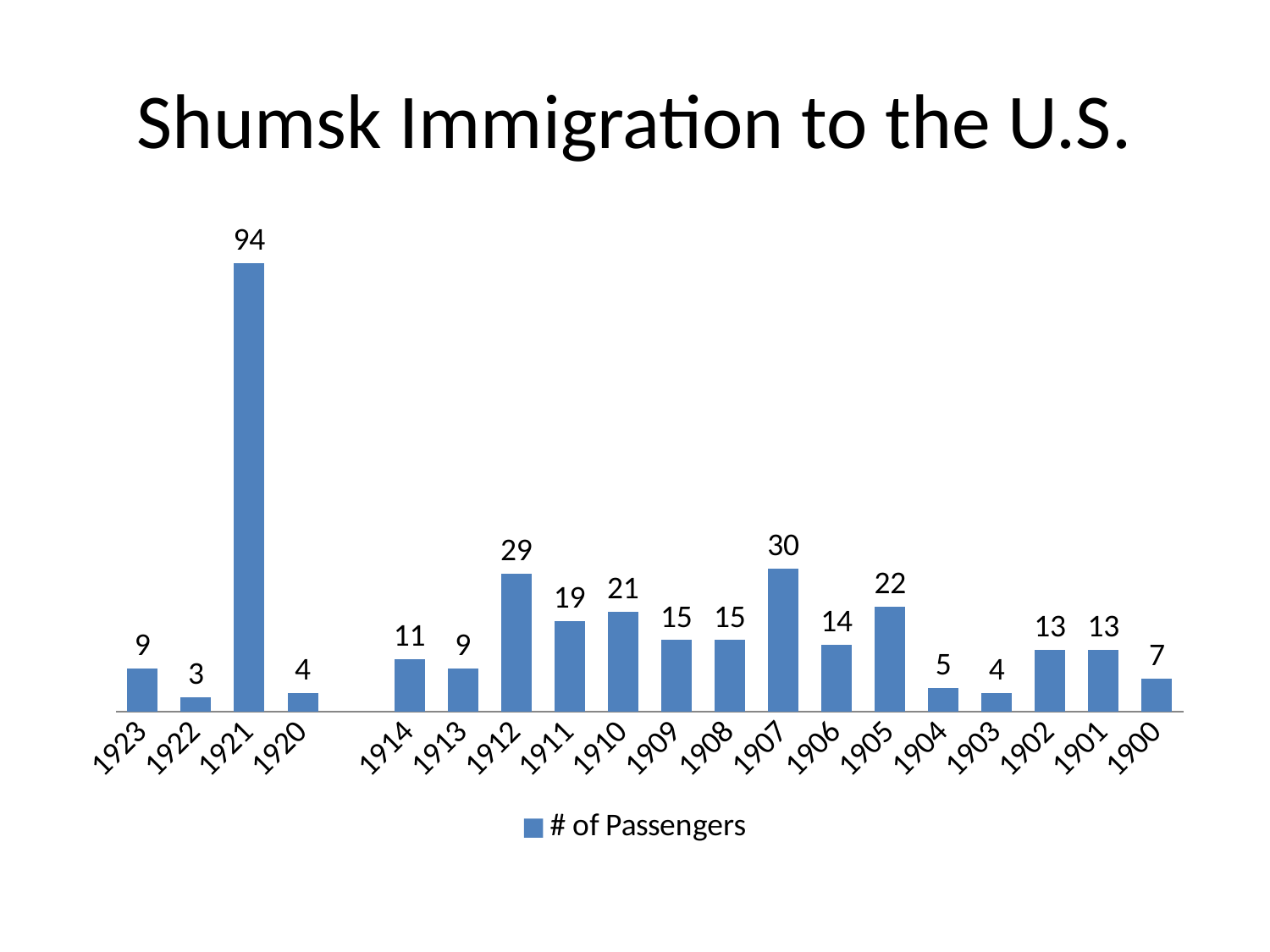
Which year has the highest number of passengers? 1921 What is the difference in passengers between 1912 and 1911? 10 What is the difference in passengers between 1921 and 1907? 64 What kind of chart is shown on the slide? Bar chart Which year has the lowest number of passengers? 1922 What is the number of passengers for 1921? 94 Which year has more passengers, 1910 or 1906? 1910 What series name does the legend show? # of Passengers Which year has more passengers, 1914 or 1904? 1914 How many years are labeled on the x axis of the chart? 19 What is the number of passengers for 1905? 22 What is the number of passengers for 1907? 30